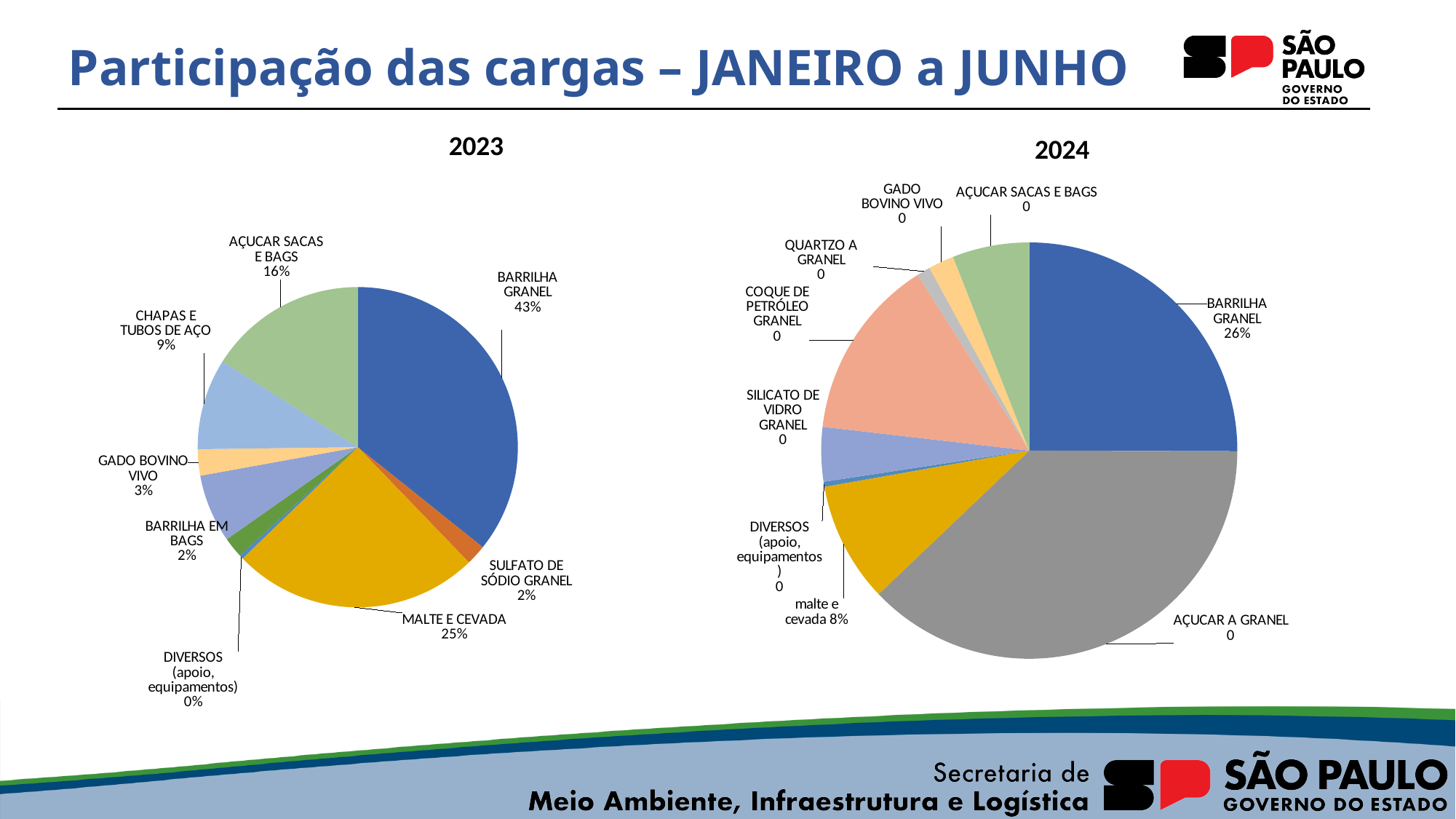
In the 2024 chart, what share does BARRILHA GRANEL have? 26% In the 2023 chart, which is larger: AÇUCAR SACAS E BAGS or CHAPAS E TUBOS DE AÇO? AÇUCAR SACAS E BAGS By how many percentage points did the share of BARRILHA GRANEL fall from the 2023 chart to the 2024 chart? 17 percentage points In the 2024 chart, which category has the largest slice? AÇUCAR A GRANEL In the 2023 chart, which category has the largest slice? BARRILHA GRANEL Is the share of BARRILHA GRANEL larger in the 2023 chart or the 2024 chart? 2023 In the 2023 chart, what share does BARRILHA GRANEL have? 43% What kind of chart is the 2023 chart? pie chart In the 2023 chart, what share does MALTE E CEVADA have? 25% In the 2023 chart, how many percentage points larger is BARRILHA GRANEL than MALTE E CEVADA? 18 percentage points In the 2024 chart, what share does malte e cevada have? 8%